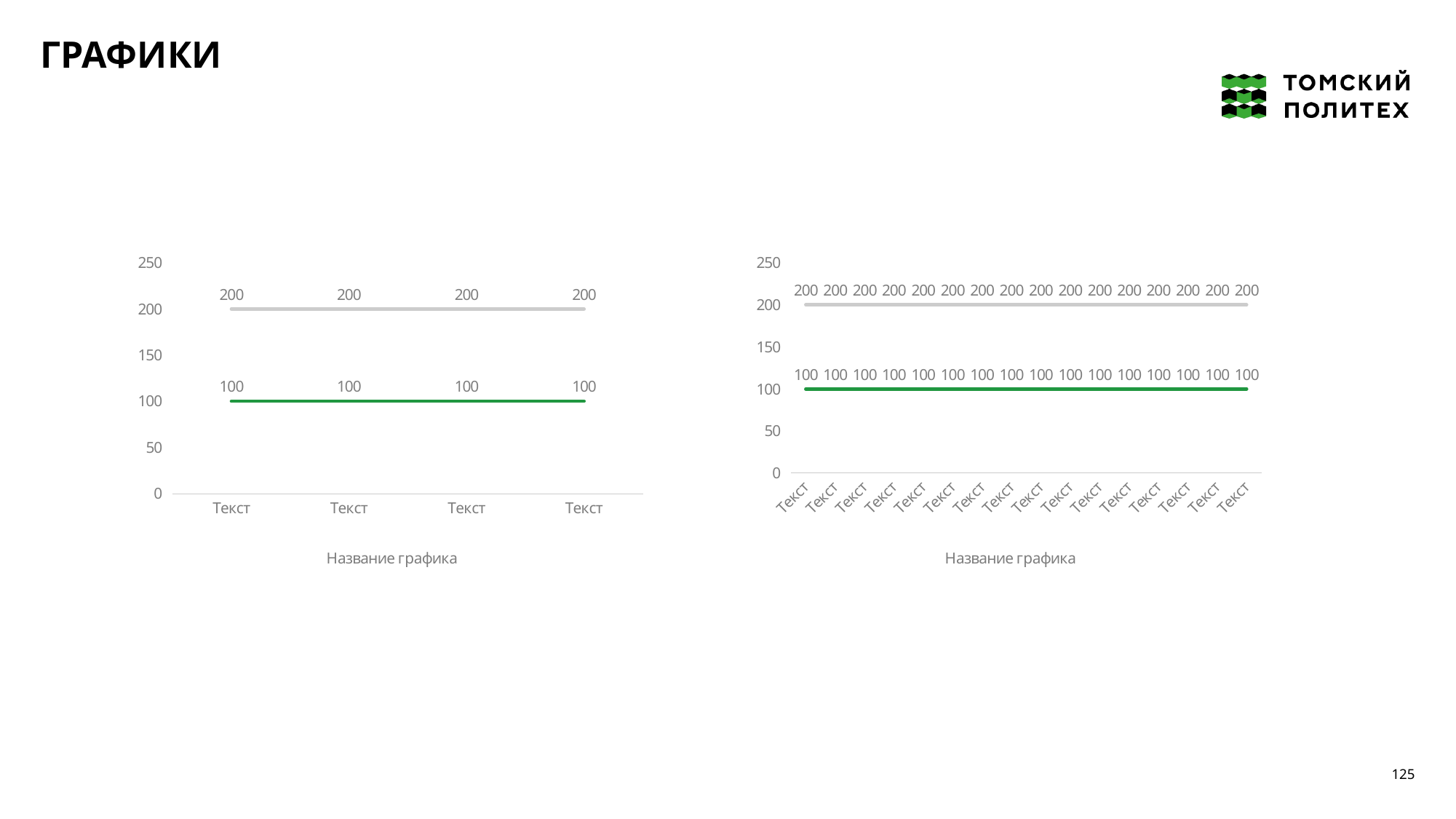
What kind of chart is the left chart on the slide? line chart In the left chart, what value is labelled on the green line at each point? 100 What kind of chart is the right chart on the slide? line chart In the right chart, do the values of the grey line rise, fall or stay flat along the x axis? stay flat In the right chart, how many categories are shown on the x axis? 16 In the right chart, what is the difference between the grey line value and the green line value at any point? 100 In the right chart, what value is labelled on the green line at each point? 100 In the left chart, what value is labelled on the grey line at each point? 200 In the left chart, which line has the higher values, the grey line or the green line? the grey line In the left chart, do the values of the green line rise, fall or stay flat along the x axis? stay flat What is the title shown below the left chart? Название графика In the left chart, how many categories are shown on the x axis? 4